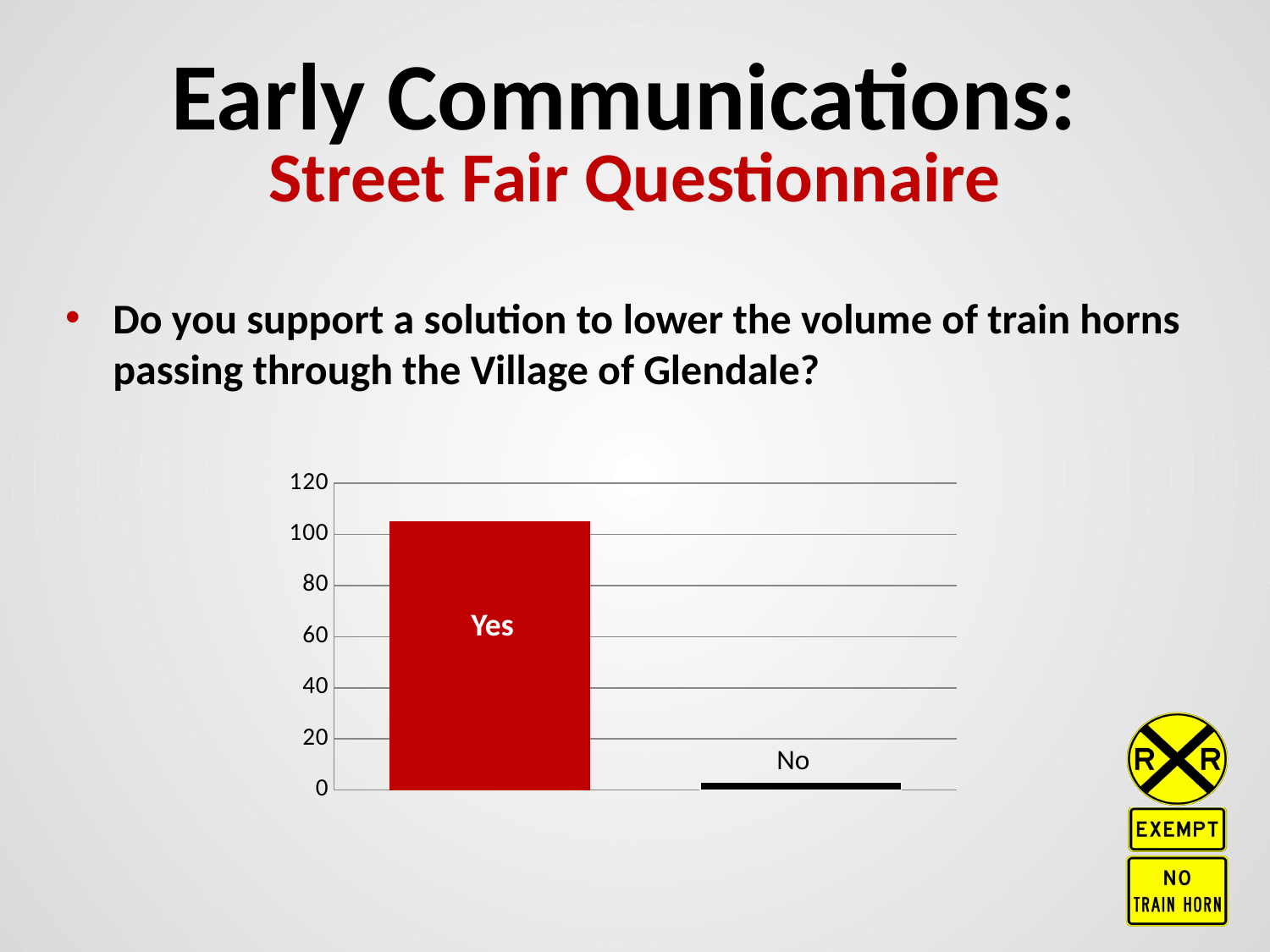
Is the value for Yes greater or less than 100? greater Is the value for Yes greater or less than 120? less What kind of chart is shown on the slide? bar chart Is the value for No greater or less than 20? less What is the highest value shown on the chart's vertical axis? 120 Which response has the lowest bar in the chart? No How many bars does the chart show? 2 What colour is the Yes bar in the chart? red Do the bar values rise or fall going from Yes to No along the x axis? fall Which response has the highest bar in the chart? Yes Which is larger, the value for Yes or the value for No? Yes